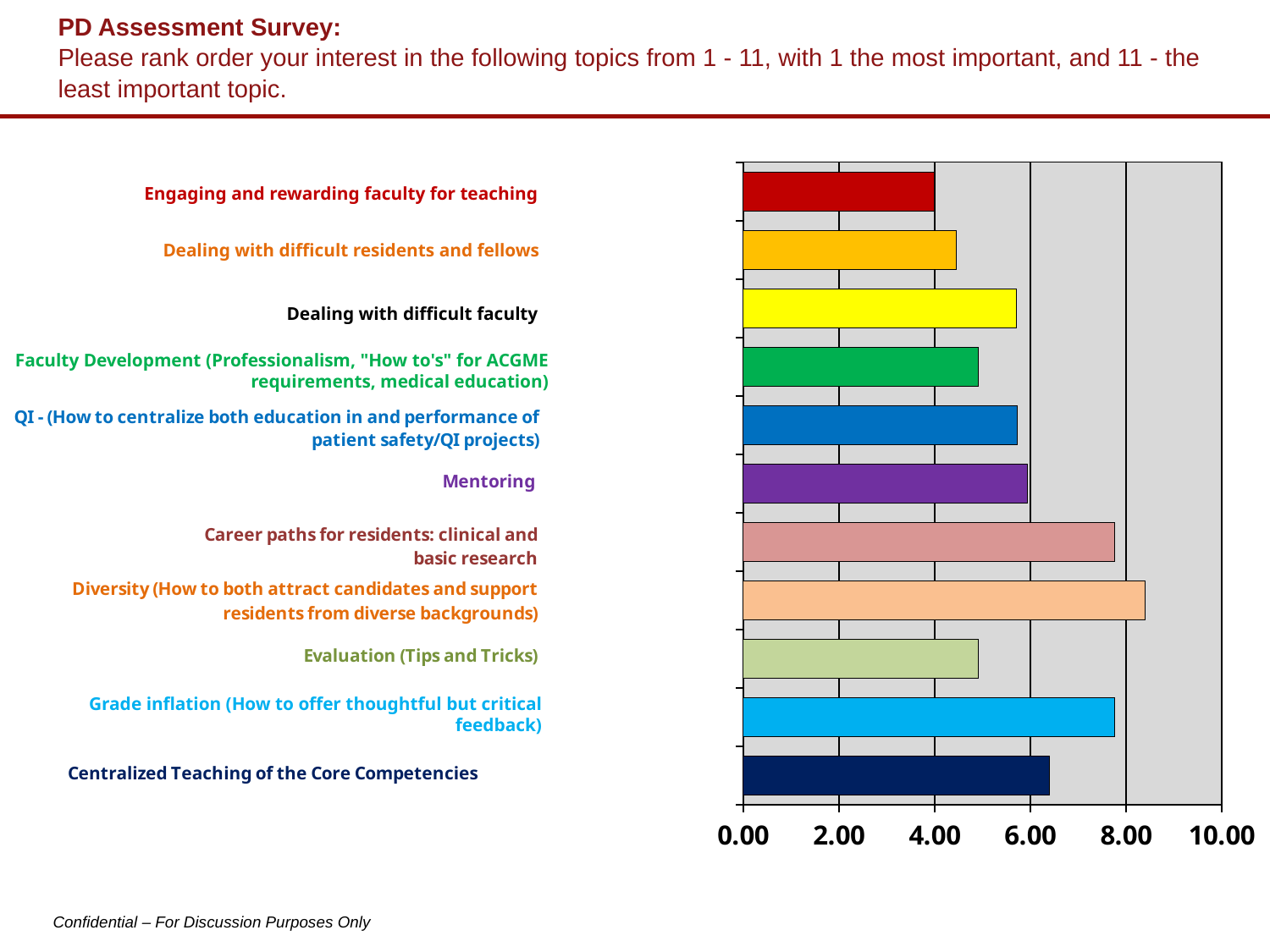
Is the value for Evaluation (Tips and Tricks) greater or less than 6.00? less How many topics (categories) are plotted in the chart? 11 What kind of chart is shown on the slide? bar chart Which has the larger value: Dealing with difficult faculty or Faculty Development (Professionalism, "How to's" for ACGME requirements, medical education)? Dealing with difficult faculty What colour is the bar for Mentoring? purple Is the value for Career paths for residents: clinical and basic research greater or less than 8.00? less Is the value for Diversity (How to both attract candidates and support residents from diverse backgrounds) greater or less than 8.00? greater Which topic has the lowest value in the chart? Engaging and rewarding faculty for teaching Which has the larger value: Diversity (How to both attract candidates and support residents from diverse backgrounds) or Career paths for residents: clinical and basic research? Diversity (How to both attract candidates and support residents from diverse backgrounds) Which topic has the highest value in the chart? Diversity (How to both attract candidates and support residents from diverse backgrounds)